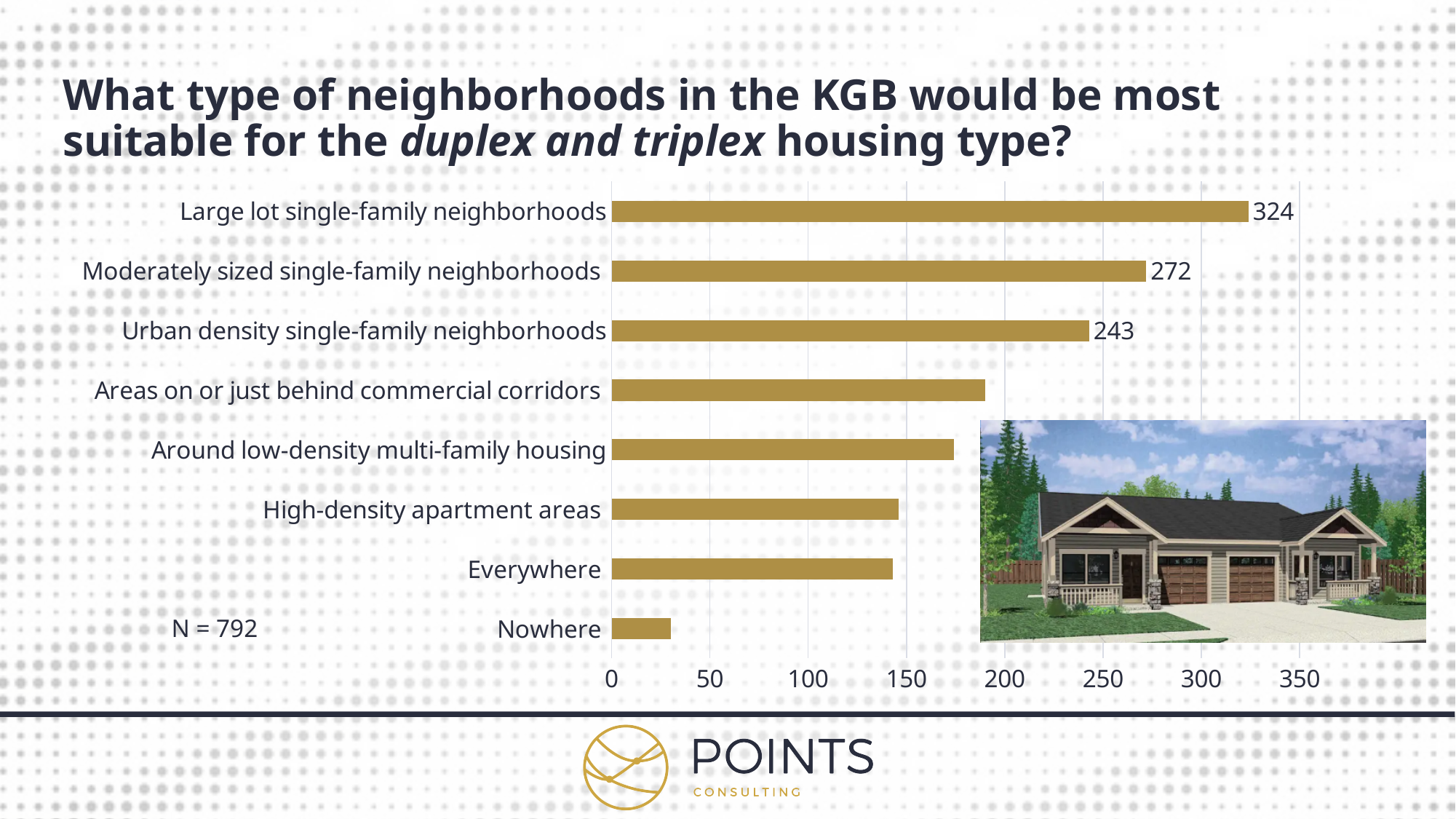
How many categories are shown in the chart? 8 Is the value for Areas on or just behind commercial corridors greater or less than 150? greater What kind of chart is shown on the slide? bar chart Which is larger: the value for Areas on or just behind commercial corridors or the value for Around low-density multi-family housing? Areas on or just behind commercial corridors Which category has the lowest value? Nowhere What is the value for Moderately sized single-family neighborhoods? 272 What is the difference between the values for Moderately sized single-family neighborhoods and Urban density single-family neighborhoods? 29 What is the value for Large lot single-family neighborhoods? 324 Which category has the highest value? Large lot single-family neighborhoods What is the value for Urban density single-family neighborhoods? 243 Is the value for Nowhere greater or less than 50? less What is the difference between the values for Large lot single-family neighborhoods and Moderately sized single-family neighborhoods? 52